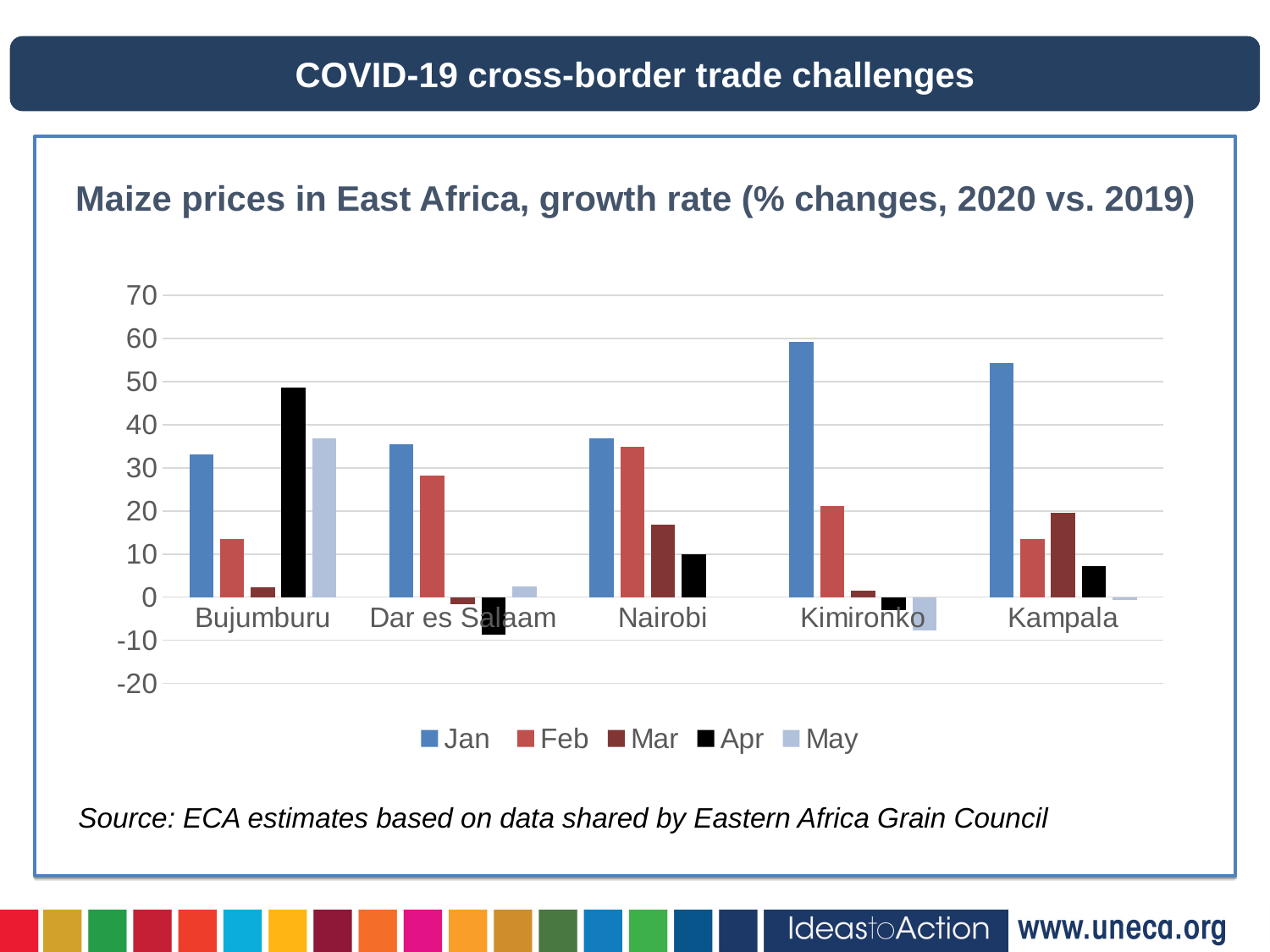
For Bujumburu, which is larger: the Jan value or the Apr value? Apr For Dar es Salaam, which month has the lowest value? Apr Which city has the highest Jan value? Kimironko Do the values for Nairobi rise or fall from Jan to Apr? fall Which is larger: the Jan value for Nairobi or the Jan value for Kampala? Kampala What colour represents Apr in the legend? black Is the Apr value for Bujumburu greater or less than 40? greater What kind of chart is shown on the slide? bar chart Is the Apr value for Dar es Salaam greater or less than 0? less How many cities are shown on the x axis? 5 Is the Jan value for Kimironko greater or less than 50? greater How many series does the legend list? 5